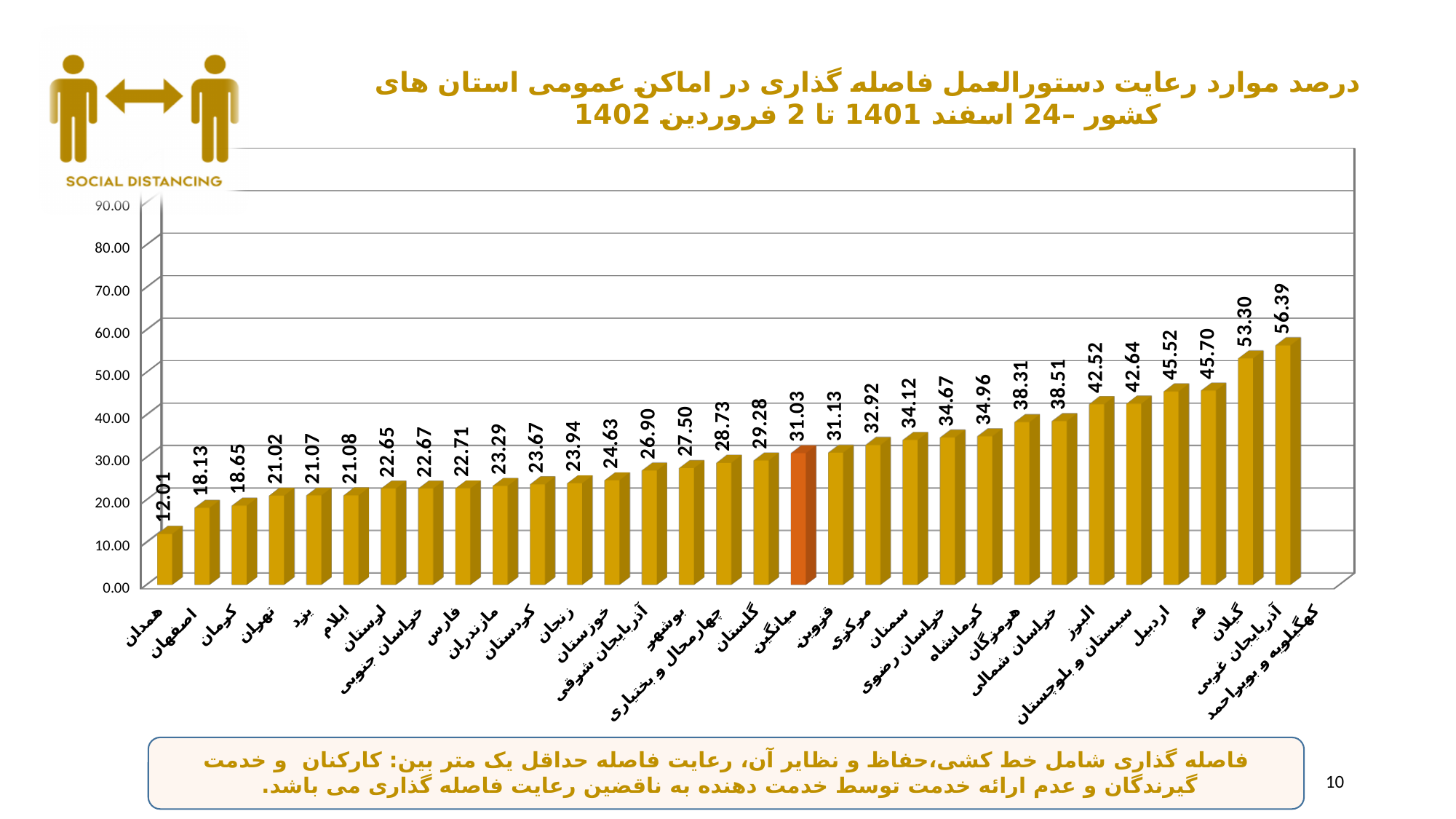
What is the value for همدان? 12.01 Do the values rise or fall from left to right along the x axis? rise What is the highest value shown on the chart? 56.39 What kind of chart is shown on the slide? bar chart What is the value for تهران? 21.02 Which is larger, the value for کرمان or the value for اصفهان? کرمان Which category has the lowest value? همدان What is the value for میانگین (the orange bar)? 31.03 What is the difference between the values for اصفهان and همدان? 6.12 Which bar is shown in a different colour (orange) from the others? میانگین Is the value for بوشهر greater or less than 30? less What is the value for گلستان? 29.28